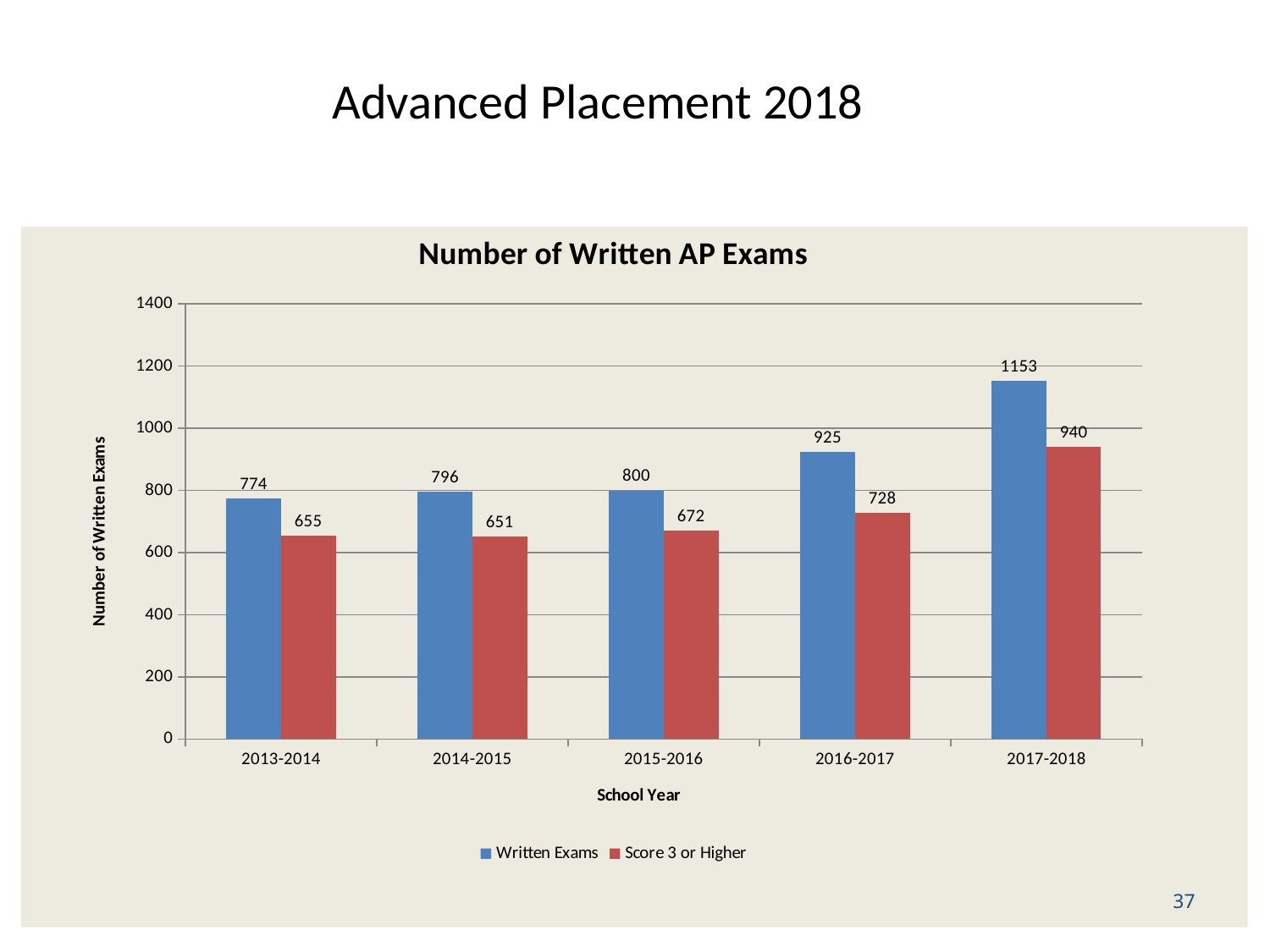
How many Written Exams were there in 2017-2018? 1153 Which school year has the lowest value for Score 3 or Higher? 2014-2015 Which is larger: Score 3 or Higher in 2017-2018 or Written Exams in 2016-2017? Score 3 or Higher in 2017-2018 What is the value for Written Exams in 2013-2014? 774 Is the value for Written Exams in 2016-2017 greater or less than 1000? less How many school years are shown on the x axis? 5 What kind of chart is shown? bar chart How many series does the legend list? 2 Which school year has the highest number of Written Exams? 2017-2018 Do the Written Exams values rise or fall from 2013-2014 to 2017-2018? rise What is the difference between Written Exams and Score 3 or Higher in 2016-2017? 197 What is the value for Score 3 or Higher in 2015-2016? 672